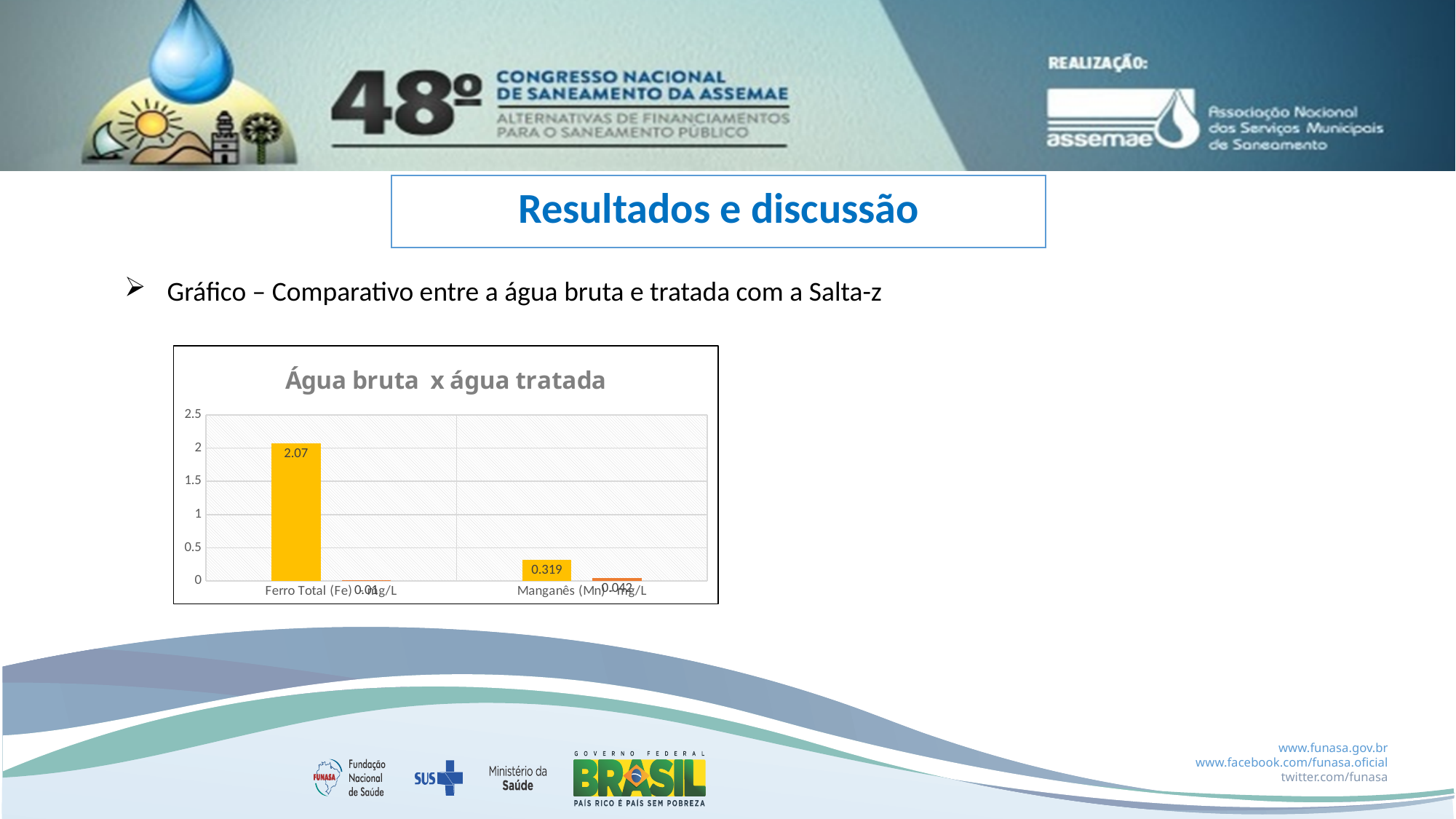
What is the value of the yellow bar for Manganês (Mn) - mg/L? 0.319 What is the difference between the yellow and orange bars for Ferro Total (Fe) - mg/L? 2.06 What type of chart is shown on the slide? bar chart How many categories are shown on the x axis of the chart? 2 What is the value of the orange bar for Ferro Total (Fe) - mg/L? 0.01 What is the value of the yellow bar for Ferro Total (Fe) - mg/L? 2.07 Which is larger: the yellow bar for Ferro Total (Fe) or the yellow bar for Manganês (Mn)? Ferro Total (Fe) What is the difference between the yellow bar values for Ferro Total (Fe) and Manganês (Mn)? 1.751 Which category has the tallest bar in the chart? Ferro Total (Fe) - mg/L What is the value of the orange bar for Manganês (Mn) - mg/L? 0.042 Is the yellow bar value for Ferro Total (Fe) greater or less than 2? greater What is the difference between the yellow and orange bars for Manganês (Mn) - mg/L? 0.277